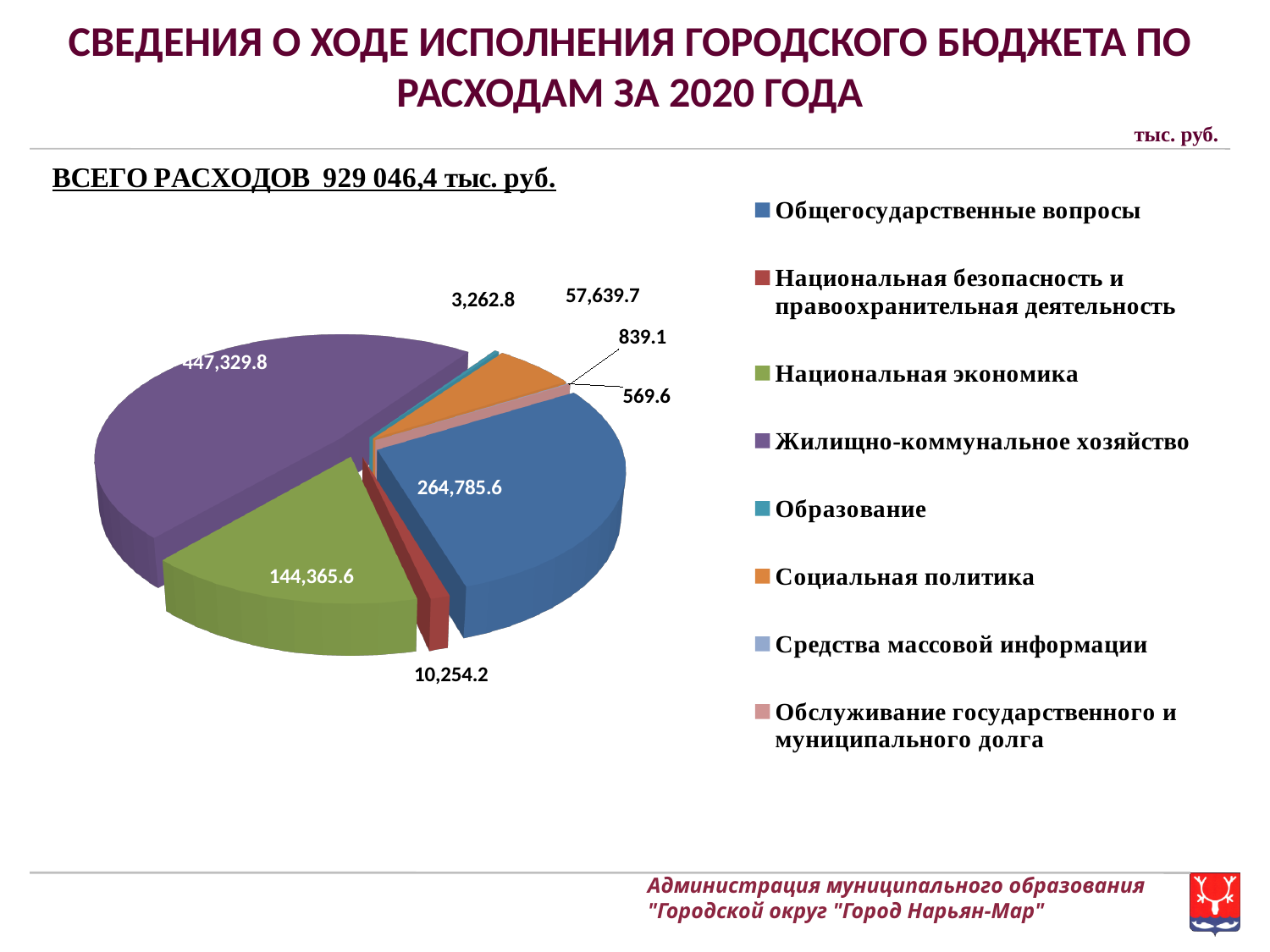
What is the value for Образование? 3,262.8 What is the value for Общегосударственные вопросы? 264,785.6 What is the difference between the values for Жилищно-коммунальное хозяйство and Общегосударственные вопросы? 182,544.2 What is the value for Национальная экономика? 144,365.6 What total expenditure amount is stated above the chart? 929 046,4 тыс. руб. What is the value for Жилищно-коммунальное хозяйство? 447,329.8 Which is larger: Общегосударственные вопросы or Национальная экономика? Общегосударственные вопросы Which category has the largest slice of the pie? Жилищно-коммунальное хозяйство What is the value for Социальная политика? 57,639.7 What is the value for Национальная безопасность и правоохранительная деятельность? 10,254.2 How many categories does the legend of the pie chart list? 8 What kind of chart is shown on the slide? Pie chart